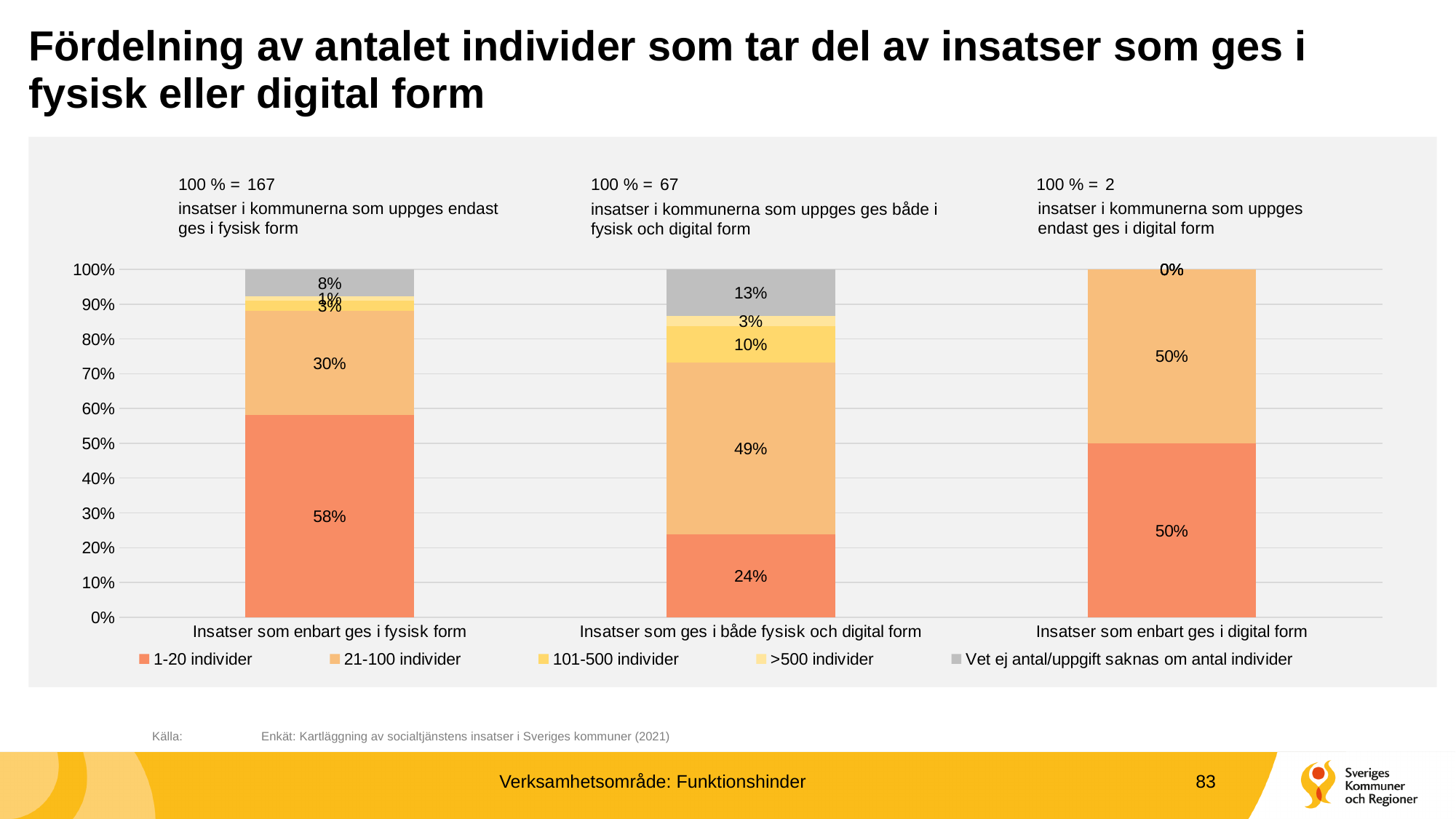
What share of 'Insatser som ges i både fysisk och digital form' is 'Vet ej antal/uppgift saknas om antal individer'? 13% What is the value for '21-100 individer' in the 'Insatser som ges i både fysisk och digital form' bar? 49% Which bar has the largest '1-20 individer' share? Insatser som enbart ges i fysisk form How many series does the legend list? 5 What is the '1-20 individer' value for 'Insatser som ges i både fysisk och digital form'? 24% What is the '101-500 individer' value for 'Insatser som ges i både fysisk och digital form'? 10% How many percentage points higher is the '1-20 individer' share for 'Insatser som enbart ges i fysisk form' than for 'Insatser som ges i både fysisk och digital form'? 34 percentage points What kind of chart is shown on the slide? Stacked bar chart How many bars (categories) are shown on the x axis? 3 What percentage of 'Insatser som enbart ges i fysisk form' falls in the '1-20 individer' category? 58% What is the 'Vet ej antal/uppgift saknas om antal individer' value for 'Insatser som enbart ges i fysisk form'? 8% What is the '21-100 individer' value for 'Insatser som enbart ges i digital form'? 50%